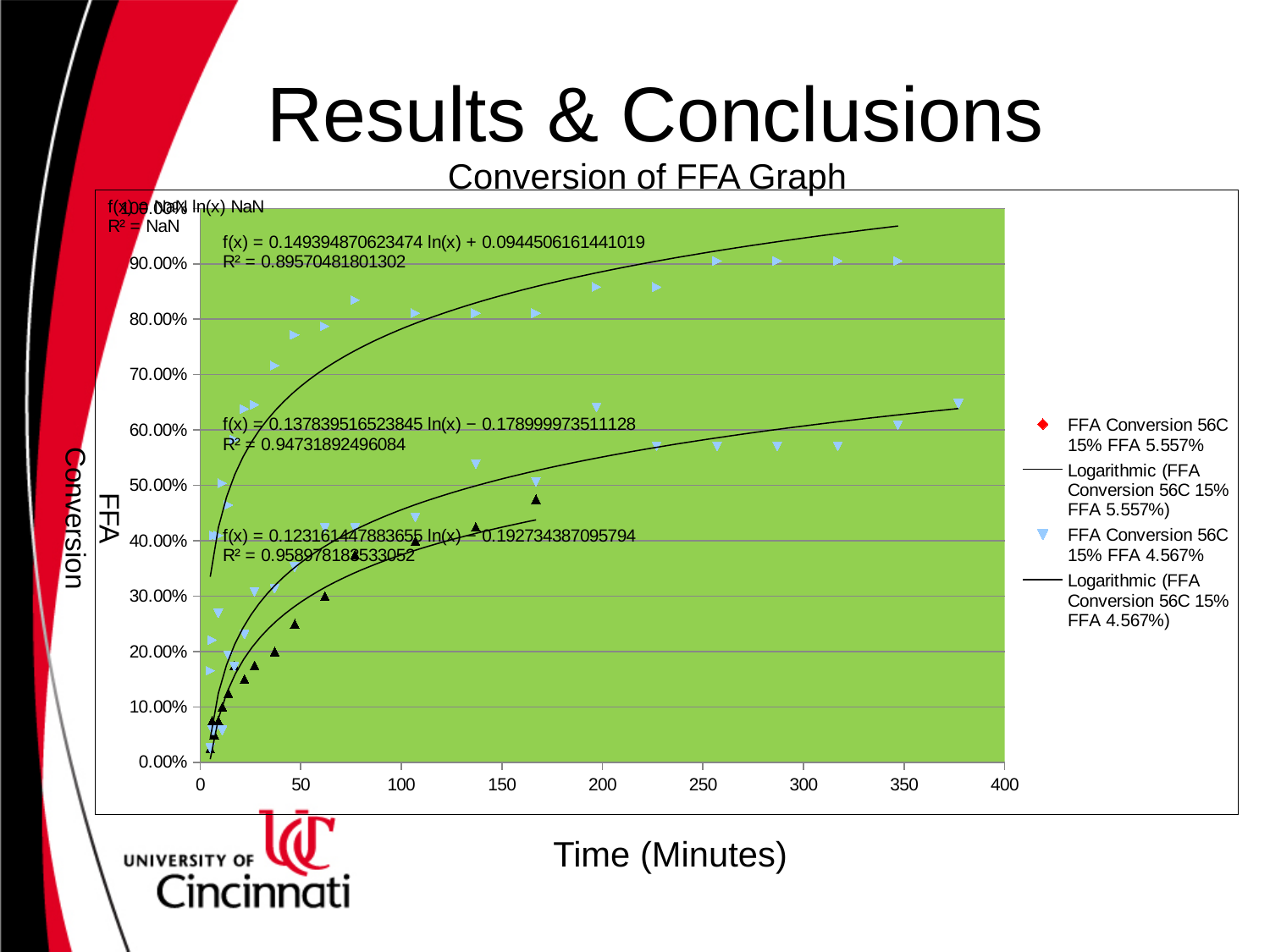
What is the R² value printed for the trendline f(x) = 0.137839516523845 ln(x) − 0.178999973511128? 0.94731892496084 Do the plotted conversion values generally rise or fall as time increases? rise What is the R² value printed for the trendline f(x) = 0.123161447883655 ln(x) − 0.192734387095794? 0.958978183533052 What is the label of the x axis? Time (Minutes) What is the title of the chart? Conversion of FFA Graph What is the highest tick value shown on the y axis? 100.00% What kind of chart is shown on the slide? scatter chart Is the highest value reached by the black triangle data points greater or less than 50.00%? less Is the value of the light blue down-triangle point at about 375 minutes greater or less than 50.00%? greater What is the R² value printed for the trendline f(x) = 0.149394870623474 ln(x) + 0.0944506161441019? 0.89570481801302 How many entries does the chart legend list? 4 What is the highest tick value shown on the x axis? 400